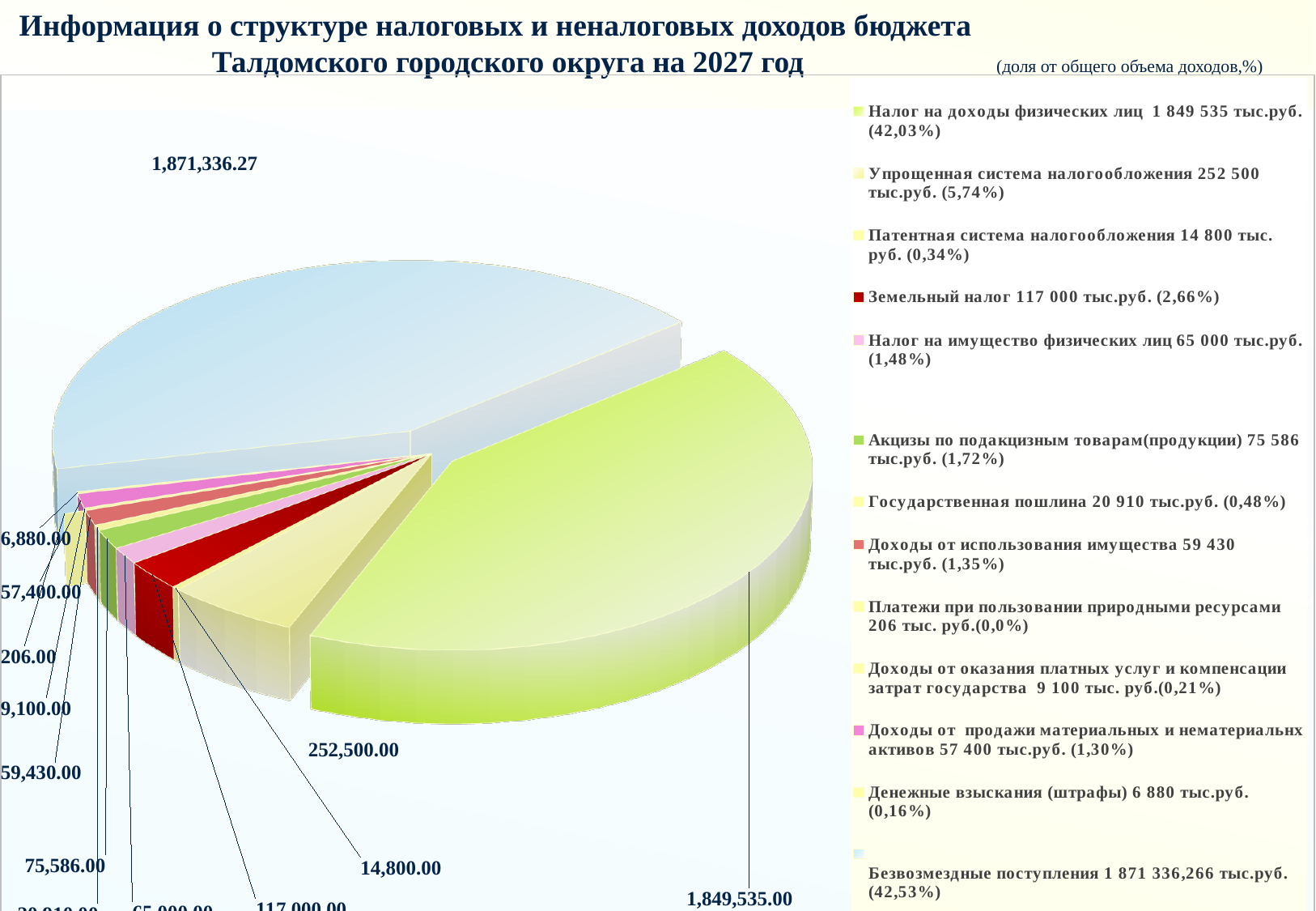
What is the data label value for the slice 'Налог на доходы физических лиц'? 1,849,535.00 What kind of chart is shown on the slide? Pie chart What is the data label value for the slice 'Земельный налог'? 117,000.00 Which category has the largest share of the pie? Безвозмездные поступления What is the data label value for the slice 'Упрощенная система налогообложения'? 252,500.00 According to the legend, what share of total revenue does 'Акцизы по подакцизным товарам(продукции)' represent? 1,72% What is the difference between the data label values for 'Упрощенная система налогообложения' and 'Земельный налог'? 135,500.00 How many categories (slices) does the pie chart have? 13 Which is larger: the value for 'Налог на имущество физических лиц' or the value for 'Доходы от использования имущества'? Налог на имущество физических лиц According to the legend, what share of total revenue does 'Безвозмездные поступления' represent? 42,53% Which category has the smallest share of the pie? Платежи при пользовании природными ресурсами What year does the chart title say the budget revenue structure refers to? 2027